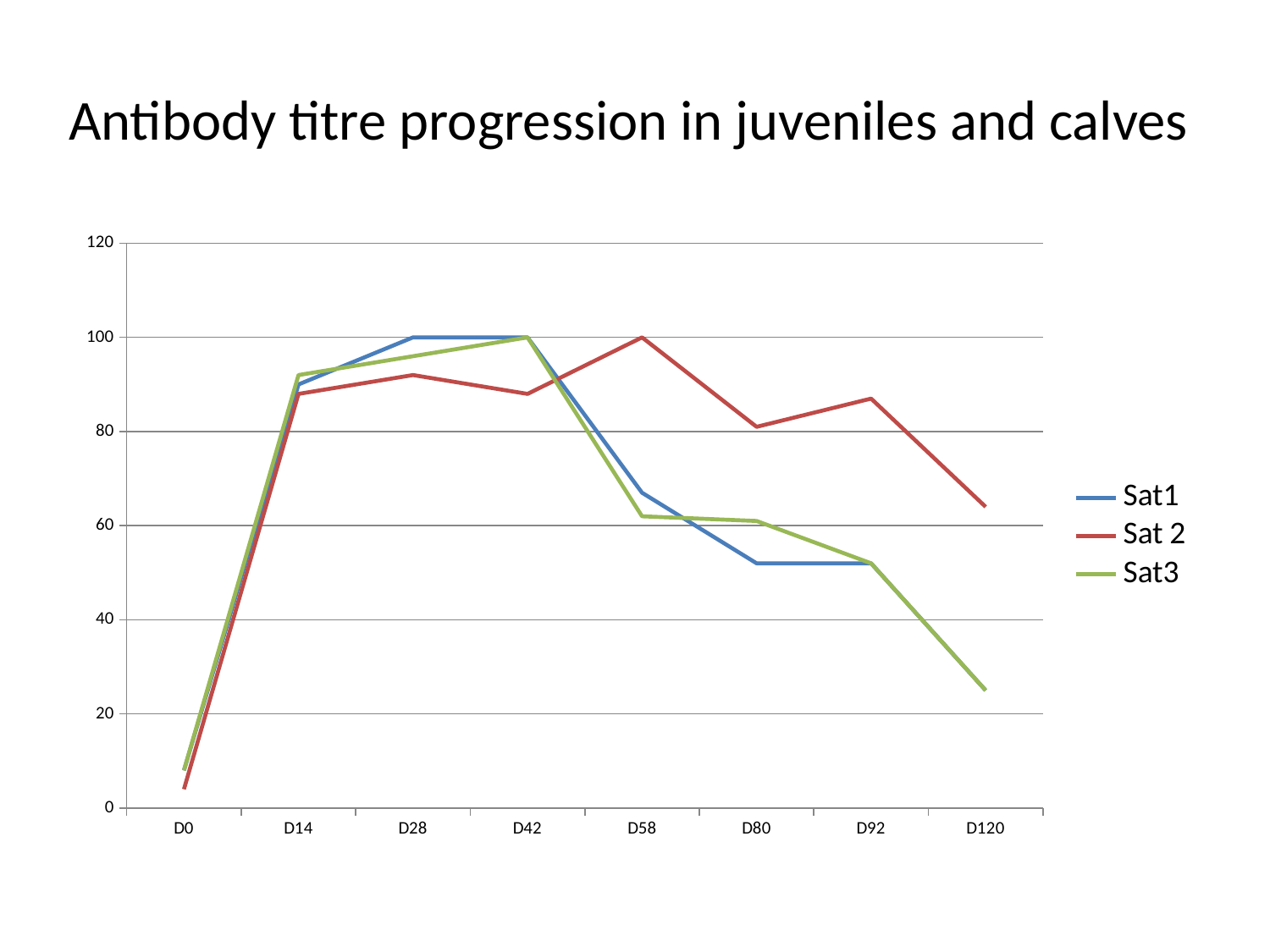
What is the value for Sat3 at D42? 100 What kind of chart is shown on the slide? line chart At D120, which series has the larger value, Sat 2 or Sat3? Sat 2 At which time point is Sat3 at its lowest value? D0 What is the value for Sat 2 at D58? 100 How many time points are shown on the x axis? 8 At which time point does Sat 2 reach its highest value? D58 Is the value for Sat 2 at D120 greater or less than 60? greater Does the Sat3 line rise or fall from D42 to D120? fall How many series does the legend list? 3 Is the value for Sat3 at D120 greater or less than 40? less What is the value for Sat1 at D28? 100